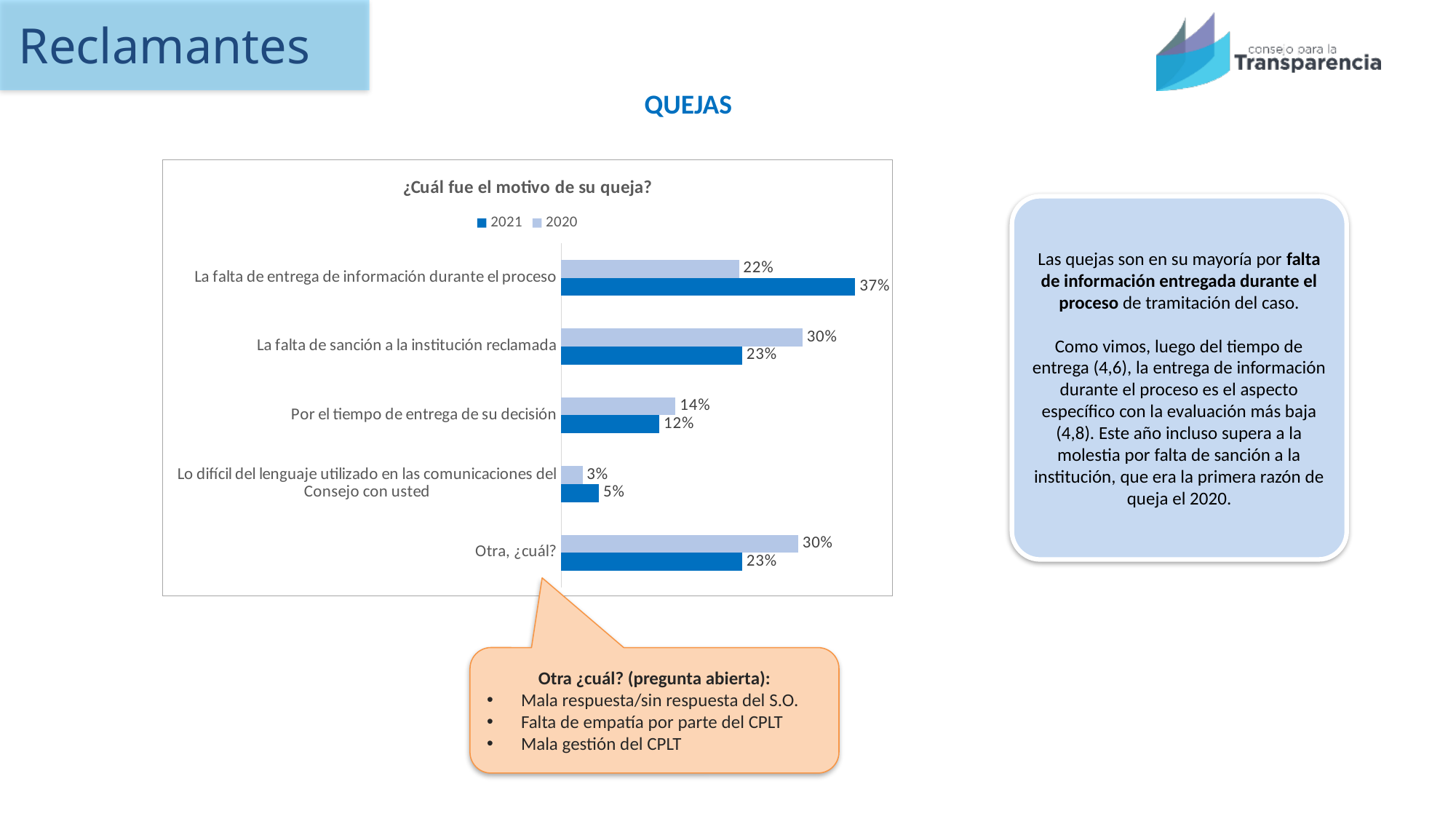
What is the difference between the 2021 and 2020 values for 'La falta de entrega de información durante el proceso'? 15% What type of chart is shown? Bar chart How many series does the legend list? 2 Which category has the lowest 2020 value? Lo difícil del lenguaje utilizado en las comunicaciones del Consejo con usted What is the 2021 value for 'La falta de entrega de información durante el proceso'? 37% For 'La falta de sanción a la institución reclamada', which year has the larger value, 2021 or 2020? 2020 What is the title of the chart? ¿Cuál fue el motivo de su queja? What is the 2020 value for 'La falta de sanción a la institución reclamada'? 30% What is the 2021 value for 'Por el tiempo de entrega de su decisión'? 12% What is the 2020 value for 'Lo difícil del lenguaje utilizado en las comunicaciones del Consejo con usted'? 3% Which category has the highest 2021 value? La falta de entrega de información durante el proceso How many categories are shown in the chart? 5